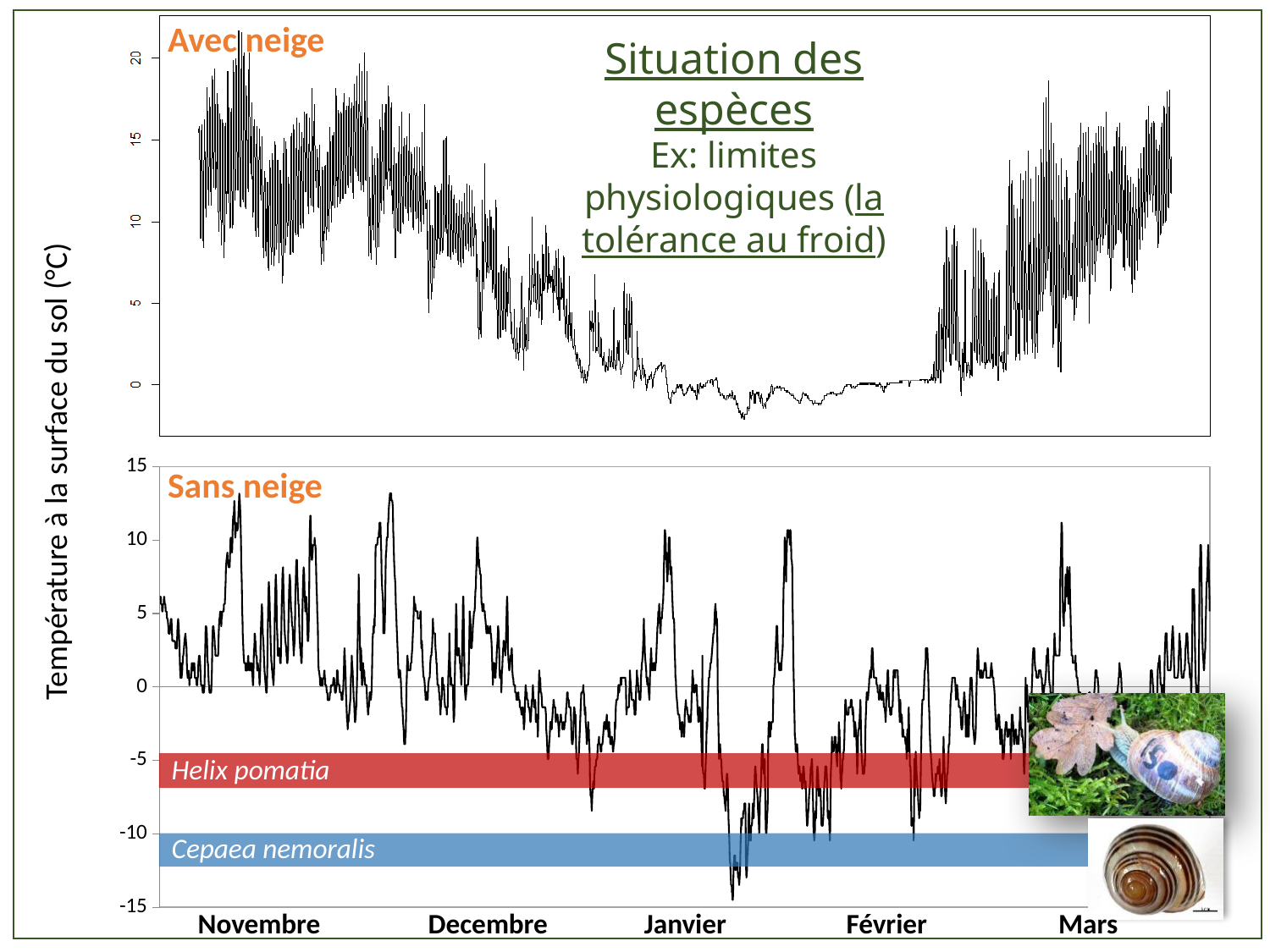
In the 'Sans neige' chart, which species band is drawn at the lower temperature, Helix pomatia or Cepaea nemoralis? Cepaea nemoralis In the 'Avec neige' chart, is the lowest value reached greater or less than 0? less In the 'Sans neige' chart, is the highest value reached greater or less than 10? greater What kind of chart is the 'Avec neige' chart at the top of the slide? line chart In the 'Sans neige' chart, is the lowest value reached greater or less than -10? less What kind of chart is the 'Sans neige' chart at the bottom of the slide? line chart In the 'Avec neige' chart, do the temperatures rise or fall from February to March? rise In the 'Avec neige' chart, do the temperatures rise or fall from November to January? fall What is the label of the shared y axis for the two charts? Température à la surface du sol (°C) Which chart reaches the higher maximum temperature, 'Avec neige' or 'Sans neige'? Avec neige How many month labels are shown along the x axis of the 'Sans neige' chart? 5